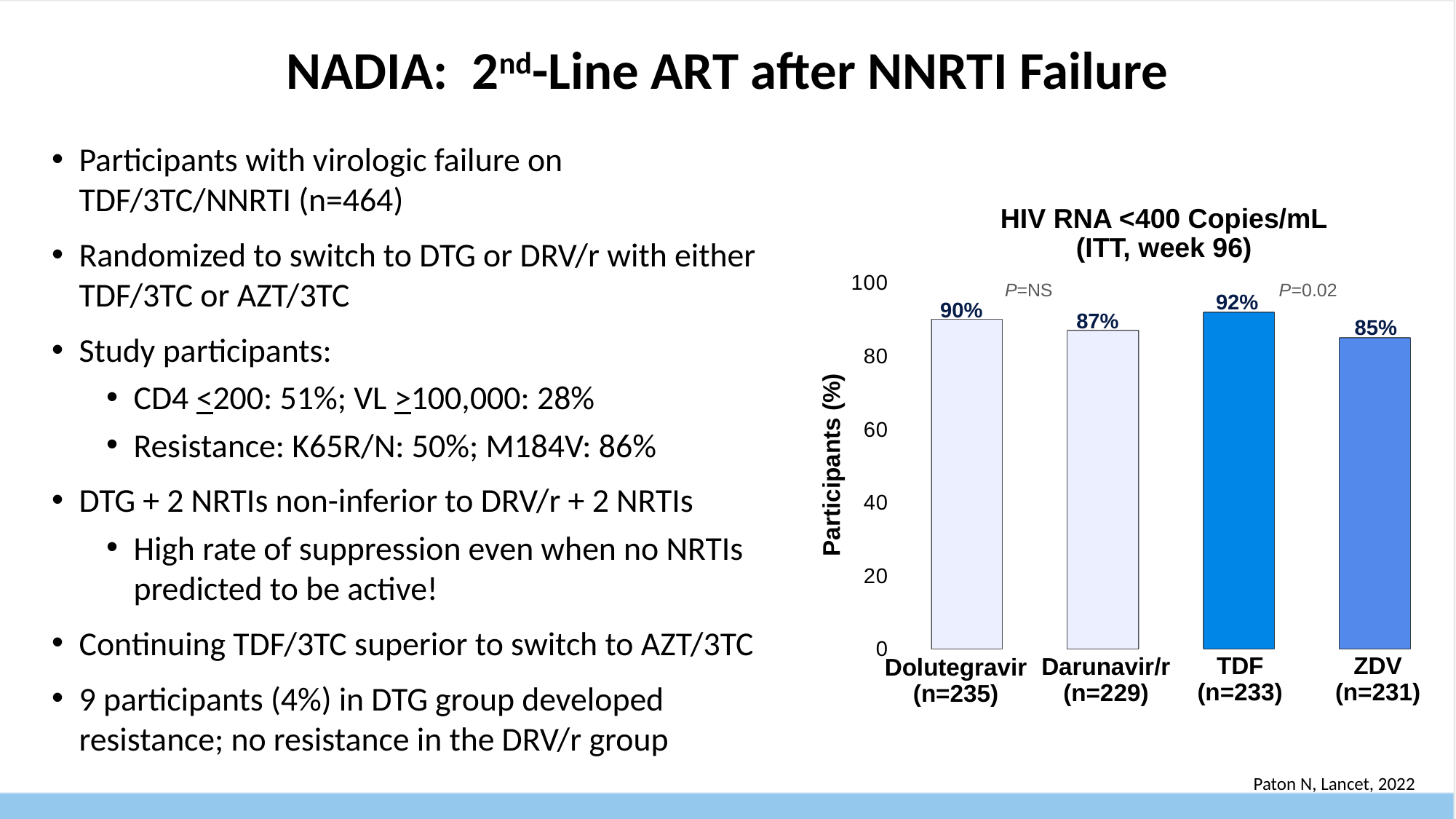
What kind of chart is shown on the slide? Bar chart Which group has the highest percentage of participants with HIV RNA <400 copies/mL? TDF (n=233) Which is larger, the value for Dolutegravir or the value for Darunavir/r? Dolutegravir What is the value shown for the TDF (n=233) bar? 92% What percentage of participants in the Dolutegravir (n=235) group had HIV RNA <400 copies/mL at week 96? 90% What is the value shown for the ZDV (n=231) bar? 85% What is the value shown for the Darunavir/r (n=229) bar? 87% What is the difference in percentage points between the TDF and ZDV bars? 7 Which group has the lowest percentage of participants with HIV RNA <400 copies/mL? ZDV (n=231) How many bars are shown in the chart? 4 What is the title of the chart? HIV RNA <400 Copies/mL (ITT, week 96) What is the difference in percentage points between the Dolutegravir and Darunavir/r bars? 3